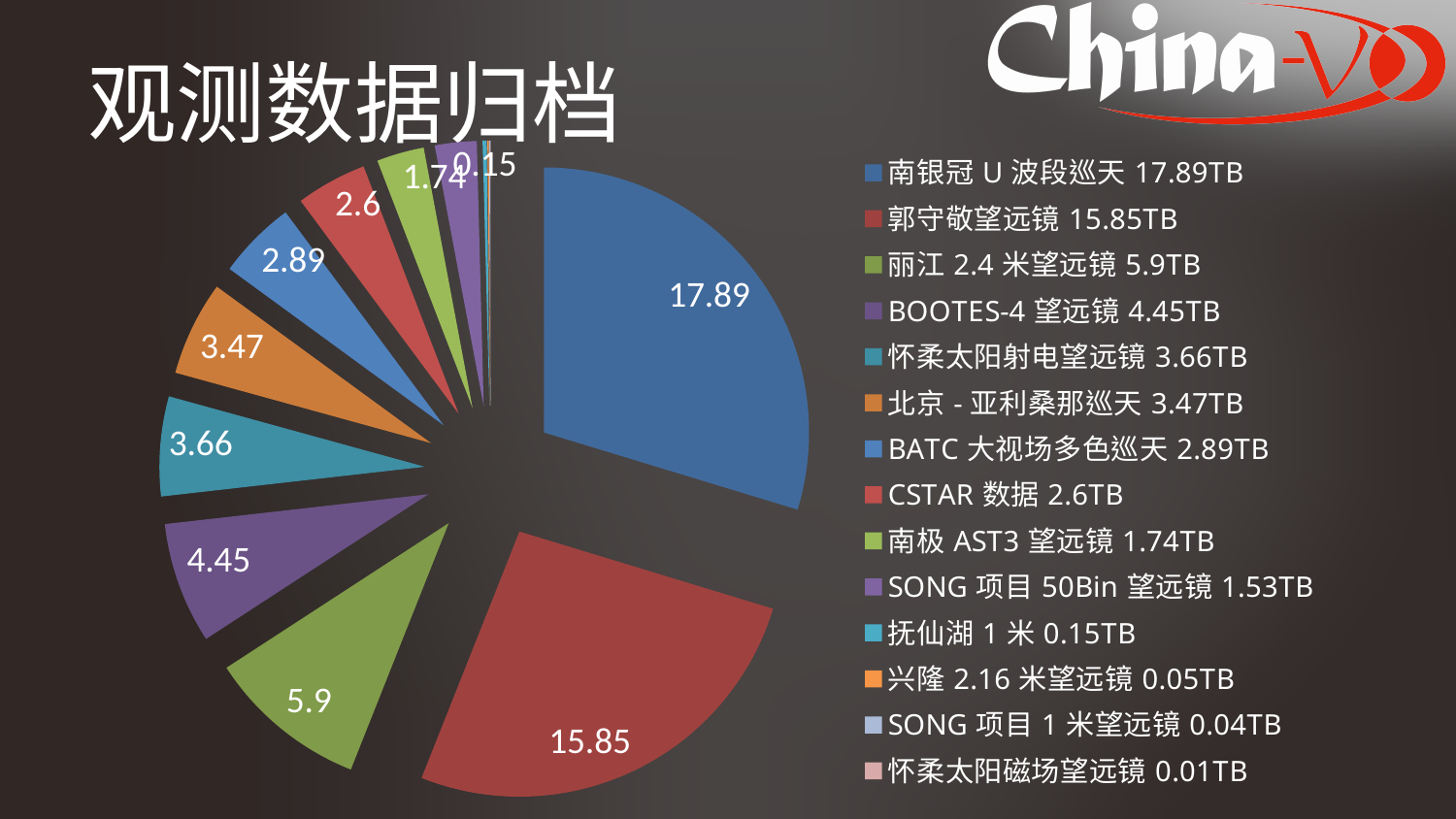
How many categories does the pie chart's legend list? 14 Which category has the smallest value in the legend? 怀柔太阳磁场望远镜 What kind of chart is shown on the slide? pie chart Which category has the largest slice of the pie? 南银冠 U 波段巡天 Which is larger, the value for 丽江 2.4 米望远镜 or BOOTES-4 望远镜? 丽江 2.4 米望远镜 What is the value for 南银冠 U 波段巡天? 17.89TB What is the value for SONG 项目 50Bin 望远镜? 1.53TB What is the difference between the values for 南银冠 U 波段巡天 and 郭守敬望远镜? 2.04TB What is the value for 郭守敬望远镜? 15.85TB What is the title of the slide containing the pie chart? 观测数据归档 What is the difference between the values for 怀柔太阳射电望远镜 and 北京 - 亚利桑那巡天? 0.19TB What is the value for 北京 - 亚利桑那巡天? 3.47TB